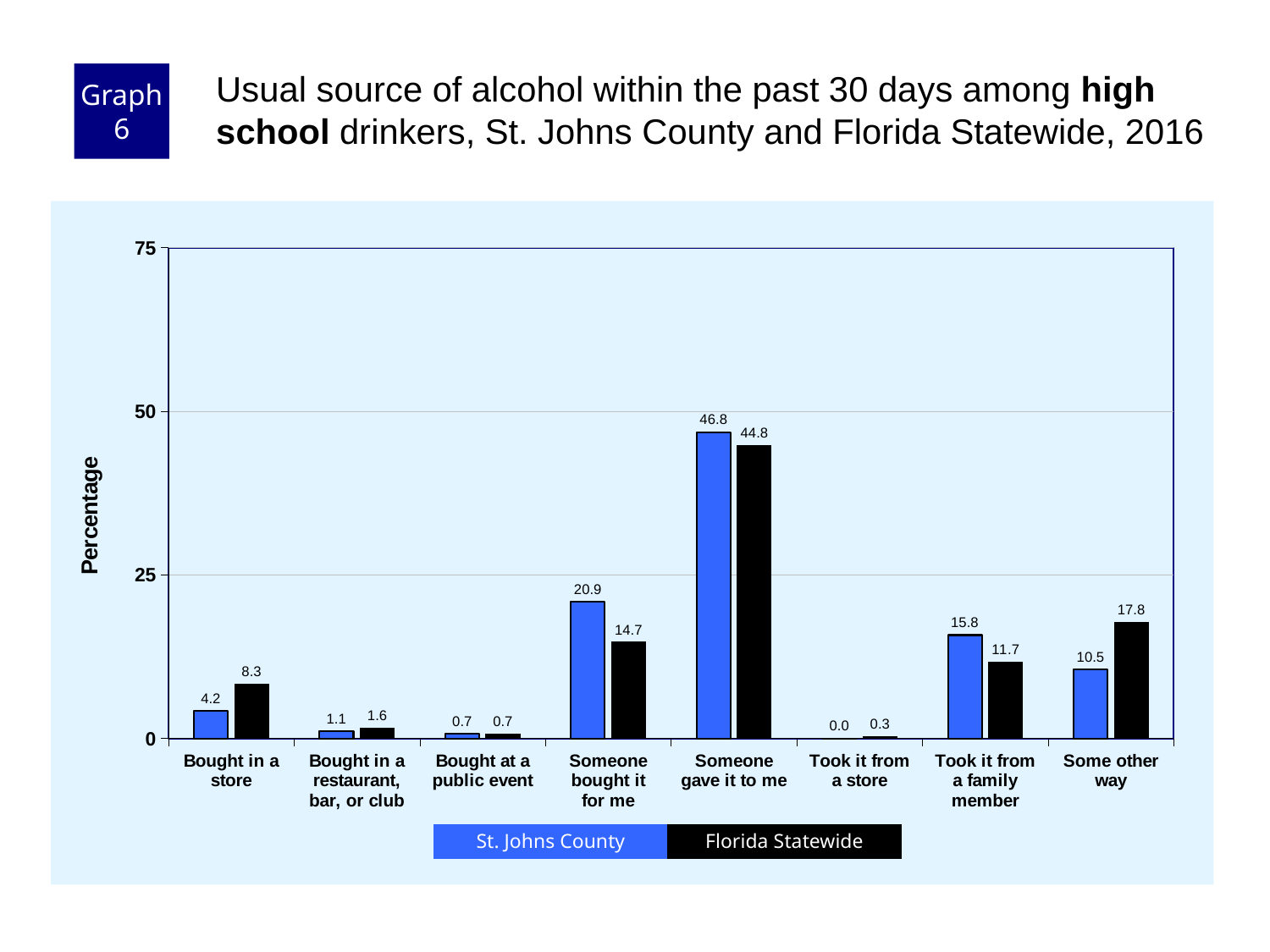
Which is larger for "Bought in a store": St. Johns County or Florida Statewide? Florida Statewide How many series does the legend list? 2 What is the St. Johns County value for "Someone gave it to me"? 46.8 What is the label of the y axis? Percentage How many categories are shown on the x axis? 8 Which category has the lowest St. Johns County value? Took it from a store Which category has the highest St. Johns County value? Someone gave it to me What kind of chart is shown on the slide? Bar chart What is the difference between the St. Johns County and Florida Statewide values for "Someone bought it for me"? 6.2 What is the Florida Statewide value for "Some other way"? 17.8 Is the Florida Statewide value for "Someone gave it to me" greater or less than 25? greater What is the Florida Statewide value for "Took it from a store"? 0.3